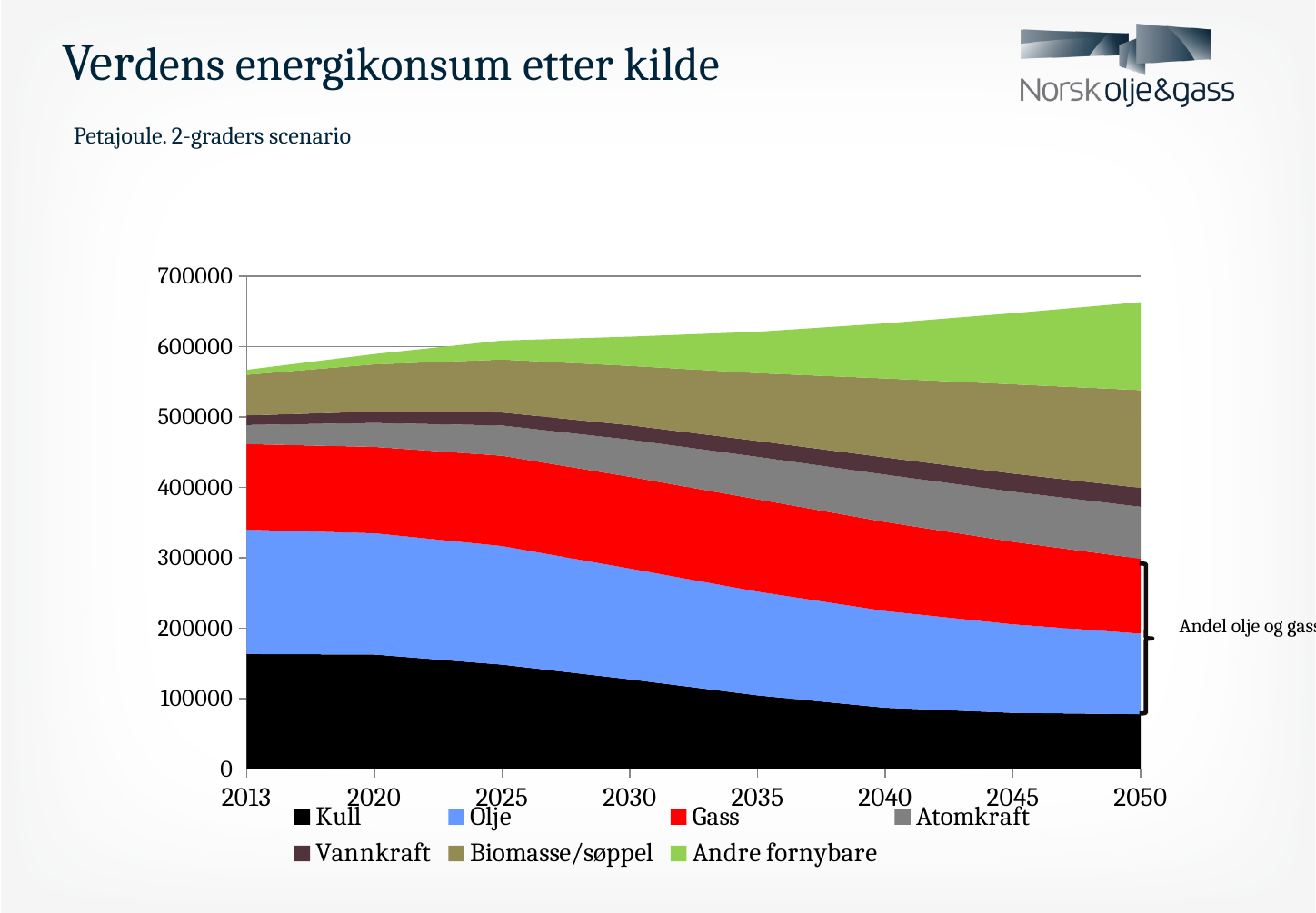
Which series is plotted at the bottom of the stack? Kull Is the value for Kull in 2050 greater or less than 100000? less Is the total stacked value in 2013 greater or less than 600000? less How many year labels are shown on the x axis? 8 How many series does the legend list? 7 What unit and scenario does the subtitle give for the chart? Petajoule. 2-graders scenario Is the total stacked value in 2050 greater or less than 600000? greater What is the title of the chart on the slide? Verdens energikonsum etter kilde Does the Andre fornybare area rise or fall from 2013 to 2050? Rises Does the Kull (coal) area rise or fall from 2013 to 2050? Falls What kind of chart is shown on the slide? Stacked area chart